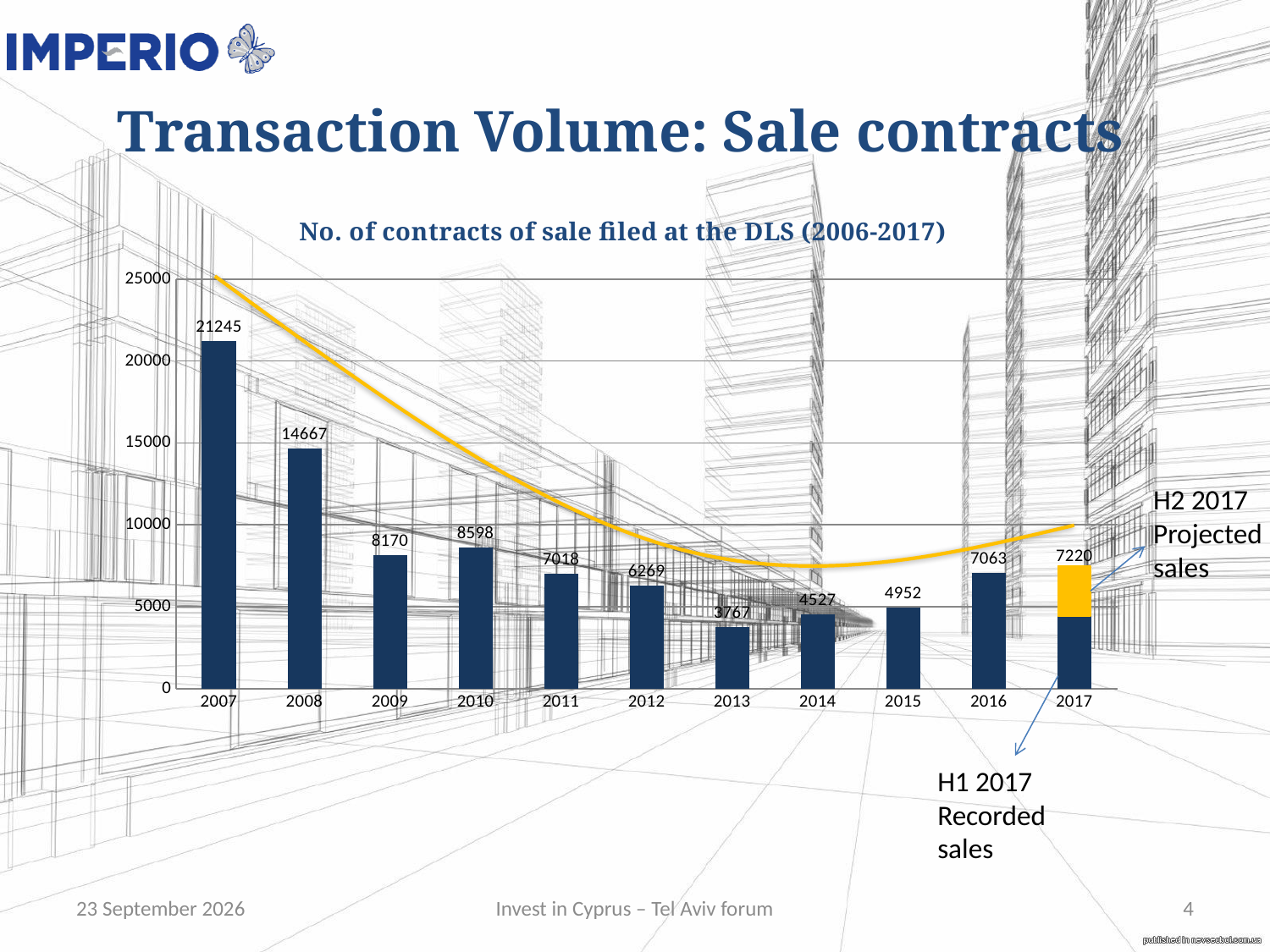
What kind of chart is used to show the number of contracts of sale? bar chart What is the number of contracts of sale filed in 2007? 21245 What is the total value labelled for 2017? 7220 Which year has the highest number of contracts of sale? 2007 Which year has a larger value, 2010 or 2011? 2010 Which year has the lowest number of contracts of sale? 2013 Is the H1 2017 recorded sales portion of the 2017 bar greater or less than 5000? less What is the value shown for 2013? 3767 How many years are shown on the x axis of the chart? 11 What is the difference between the values for 2016 and 2015? 2111 What is the difference between the values for 2007 and 2008? 6578 Do the values rise or fall from 2007 to 2013? fall